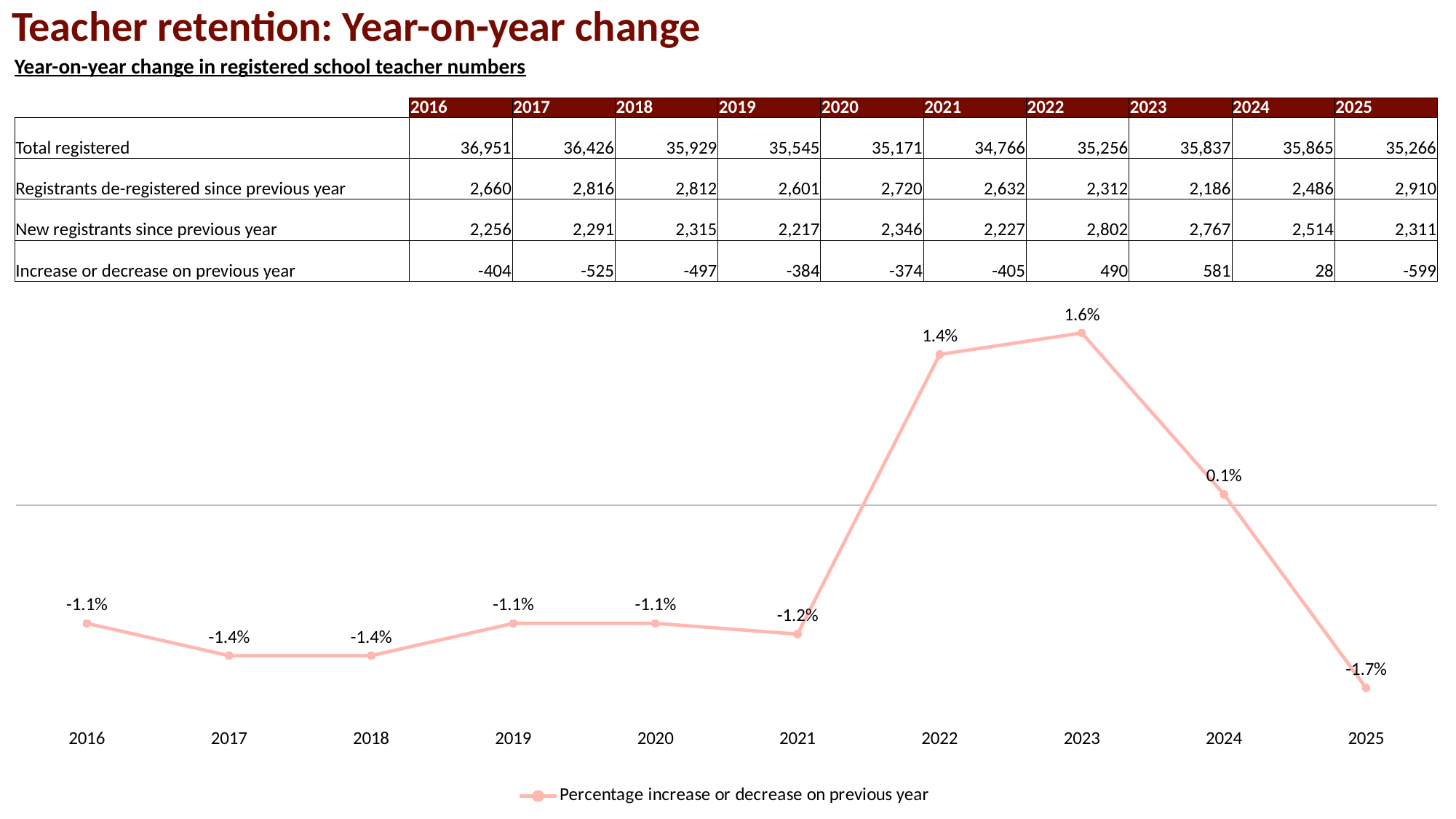
Does the percentage change value rise or fall from 2023 to 2025 in the line chart? Fall How many years are plotted on the x axis of the line chart? 10 Which year has the lowest percentage increase or decrease on previous year in the line chart? 2025 What is the percentage increase or decrease on previous year shown for 2023 in the line chart? 1.6% In the line chart, which year has the larger percentage change value, 2022 or 2024? 2022 What is the name of the series shown in the legend of the line chart? Percentage increase or decrease on previous year What is the percentage change value plotted for 2017 in the line chart? -1.4% What kind of chart is used to show the percentage increase or decrease on previous year? Line chart What is the difference between the percentage change values for 2023 and 2022 in the line chart? 0.2 percentage points How many series does the legend of the line chart list? 1 Which year has the highest percentage increase or decrease on previous year in the line chart? 2023 What is the percentage change value plotted for 2025 in the line chart? -1.7%